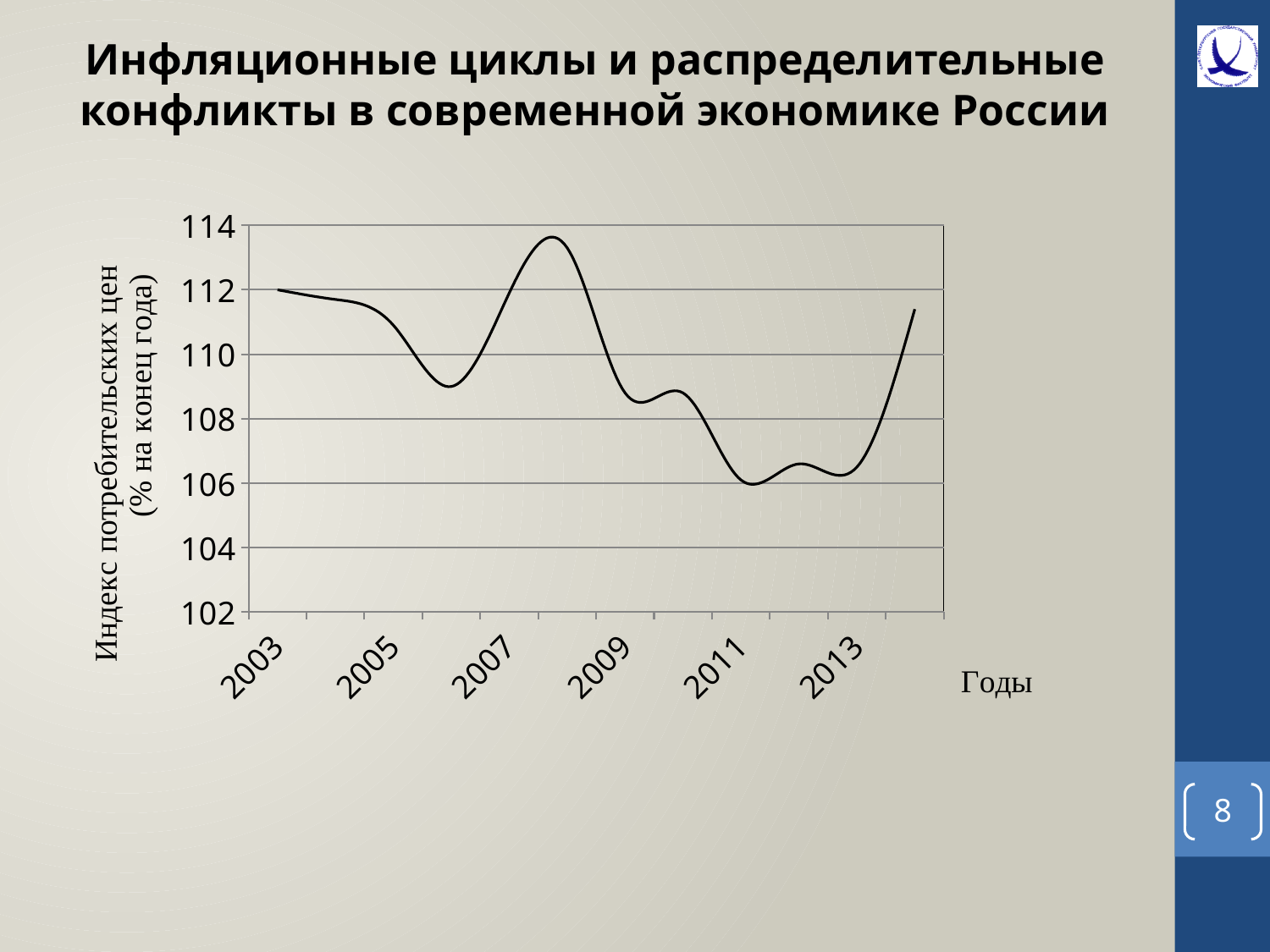
Which is larger, the value for 2003 or the value for 2011? 2003 Is the value for 2005 greater or less than 112? less Is the value for 2011 greater or less than 108? less How many year labels are shown on the x axis? 6 Which is larger, the value for 2005 or the value for 2009? 2005 What kind of chart is shown on the slide? line chart Is the highest point of the line greater or less than 112? greater Does the line rise or fall between 2003 and 2005? fall What is the title of the x axis? Годы What is the value of the consumer price index for 2003? 112